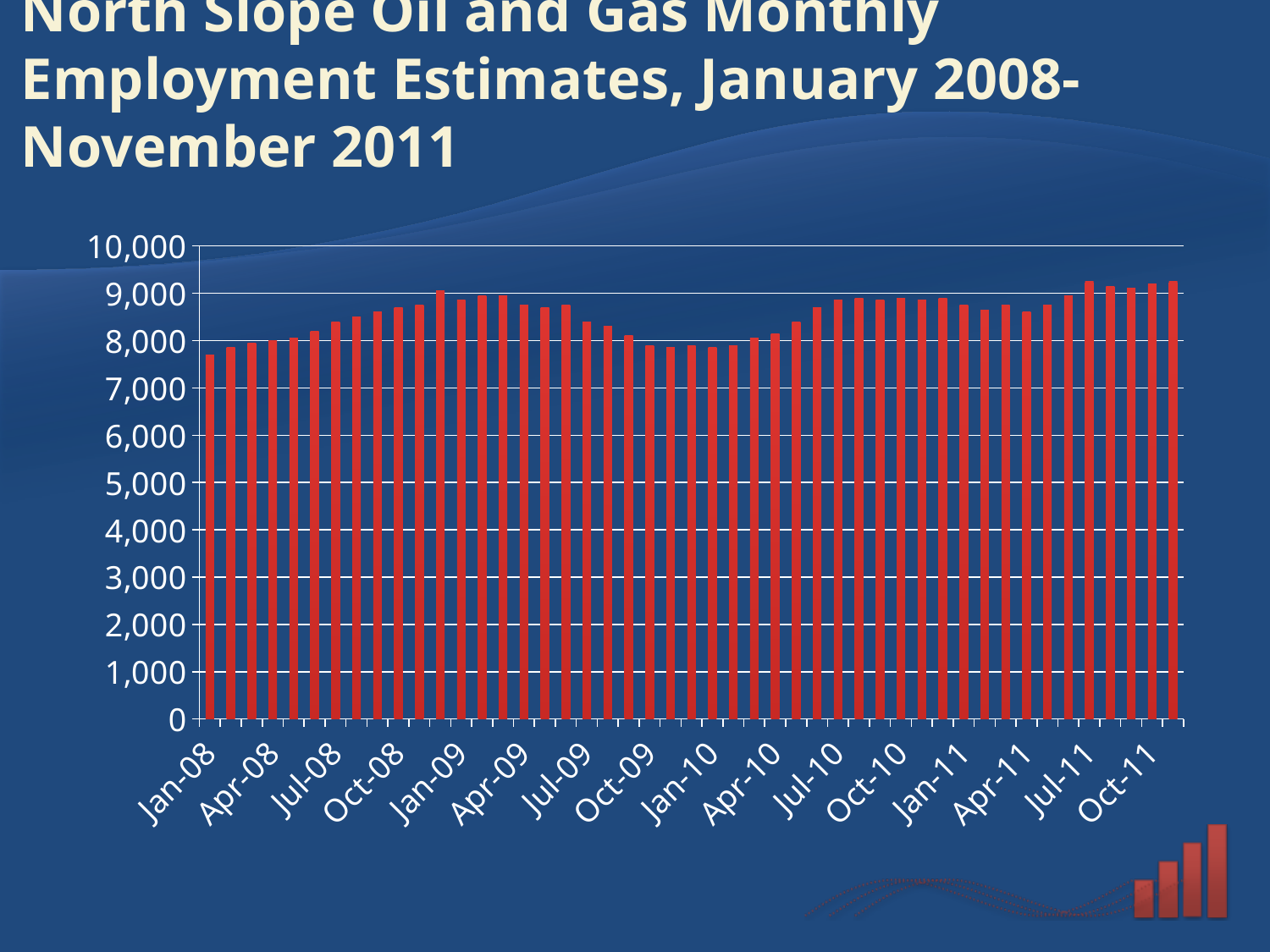
Do the employment estimates rise or fall from Jan-08 to Jan-09? rise What is the title of the chart on the slide? North Slope Oil and Gas Monthly Employment Estimates, January 2008-November 2011 Is the employment estimate for Jan-08 greater or less than 8,000? less Is the employment estimate for Jul-08 greater or less than 8,000? greater What is the highest value shown on the vertical axis of the chart? 10,000 Which is larger, the employment estimate for Jan-09 or for Jan-10? Jan-09 Which month has the lowest employment estimate in the chart? Jan-08 Is the employment estimate for Apr-11 greater or less than 8,000? greater Which is larger, the employment estimate for Oct-08 or for Oct-09? Oct-08 What kind of chart is shown on the slide? Bar chart